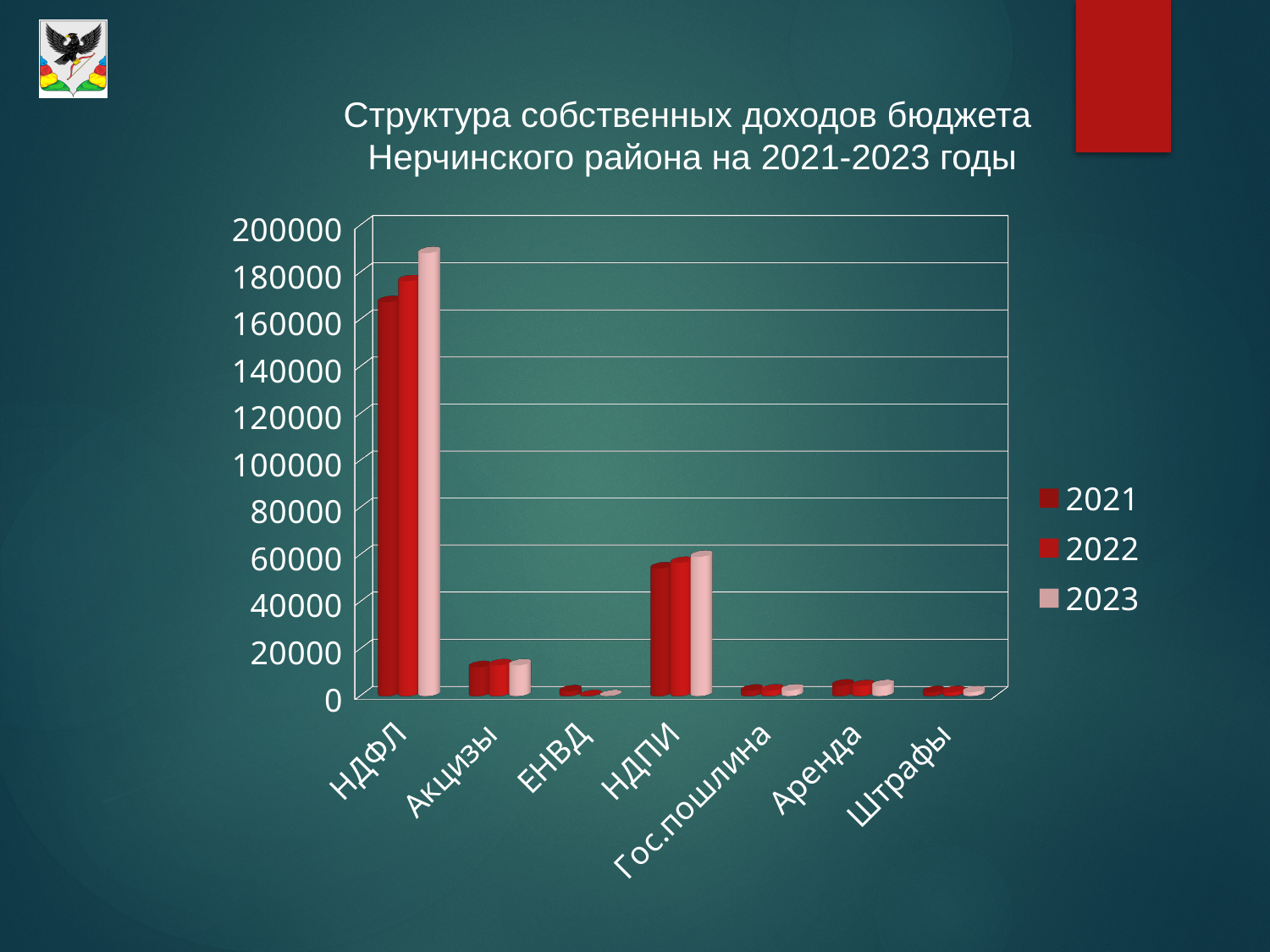
Which is larger for 2023: Акцизы or Аренда? Акцизы Do the values for НДФЛ rise or fall from 2021 to 2023? rise Which years are listed in the legend? 2021, 2022, 2023 Is the value for Акцизы in 2023 greater or less than 20000? less Which is larger for 2022: НДФЛ or НДПИ? НДФЛ Is the value for НДФЛ in 2021 greater or less than 140000? greater How many categories are shown on the x axis of the chart? 7 Which category has the highest values in the chart? НДФЛ Is the value for НДПИ in 2022 greater or less than 80000? less What kind of chart is shown on the slide? bar chart What is the title of the chart? Структура собственных доходов бюджета Нерчинского района на 2021-2023 годы How many series does the legend list? 3